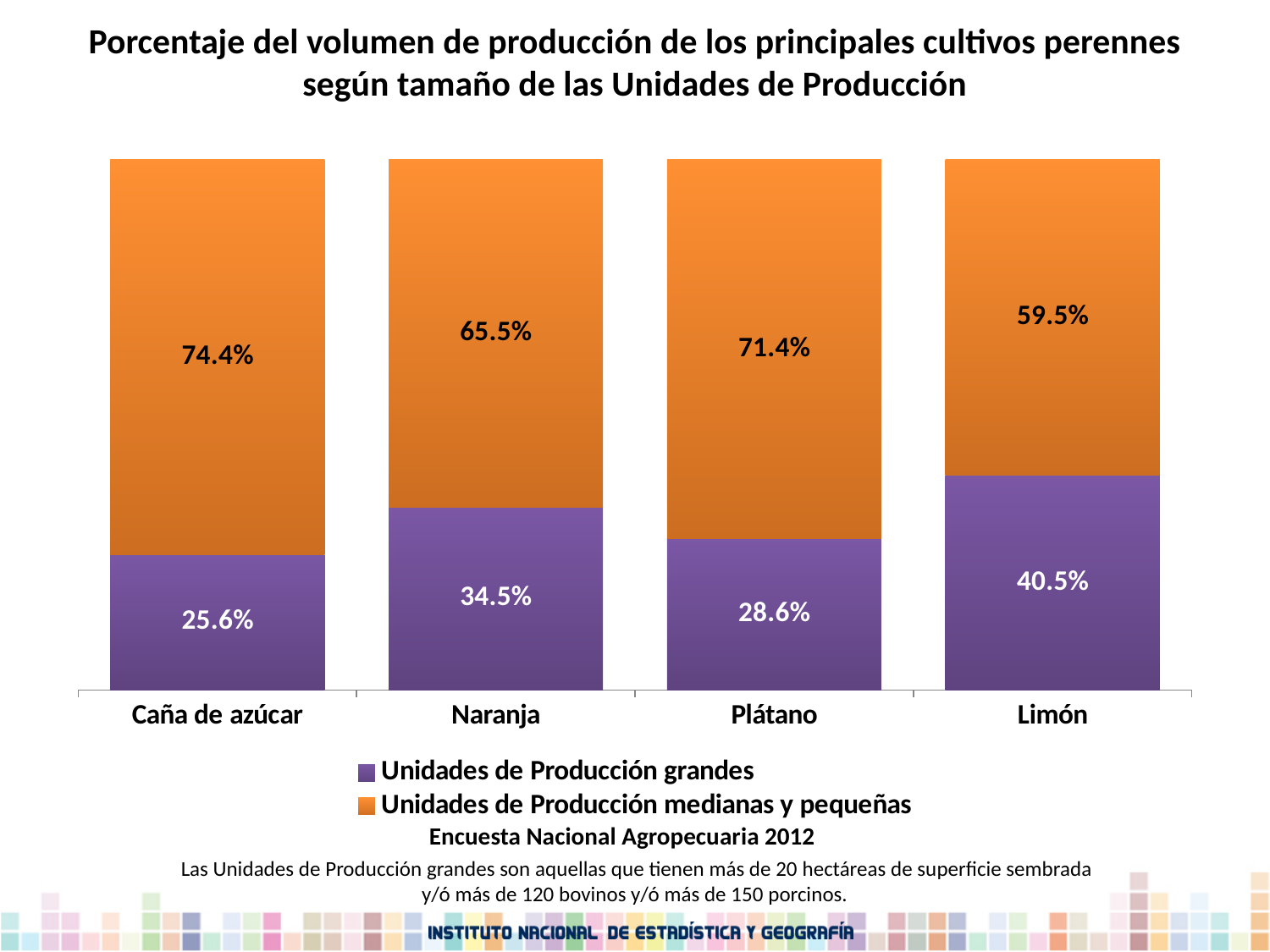
How many series does the legend list? 2 Which is larger: the Unidades de Producción grandes value for Caña de azúcar or for Plátano? Plátano What is the value for Unidades de Producción grandes for Caña de azúcar? 25.6% What kind of chart is shown on the slide? Stacked bar chart What is the total of the stacked bar for Limón? 100% What is the difference between the Unidades de Producción grandes values for Naranja and Plátano? 5.9% What is the value for Unidades de Producción grandes for Limón? 40.5% Which crop has the lowest value for Unidades de Producción medianas y pequeñas? Limón Which crop has the highest value for Unidades de Producción grandes? Limón How many crops are shown on the x axis? 4 What is the value for Unidades de Producción medianas y pequeñas for Naranja? 65.5% What is the value for Unidades de Producción medianas y pequeñas for Plátano? 71.4%